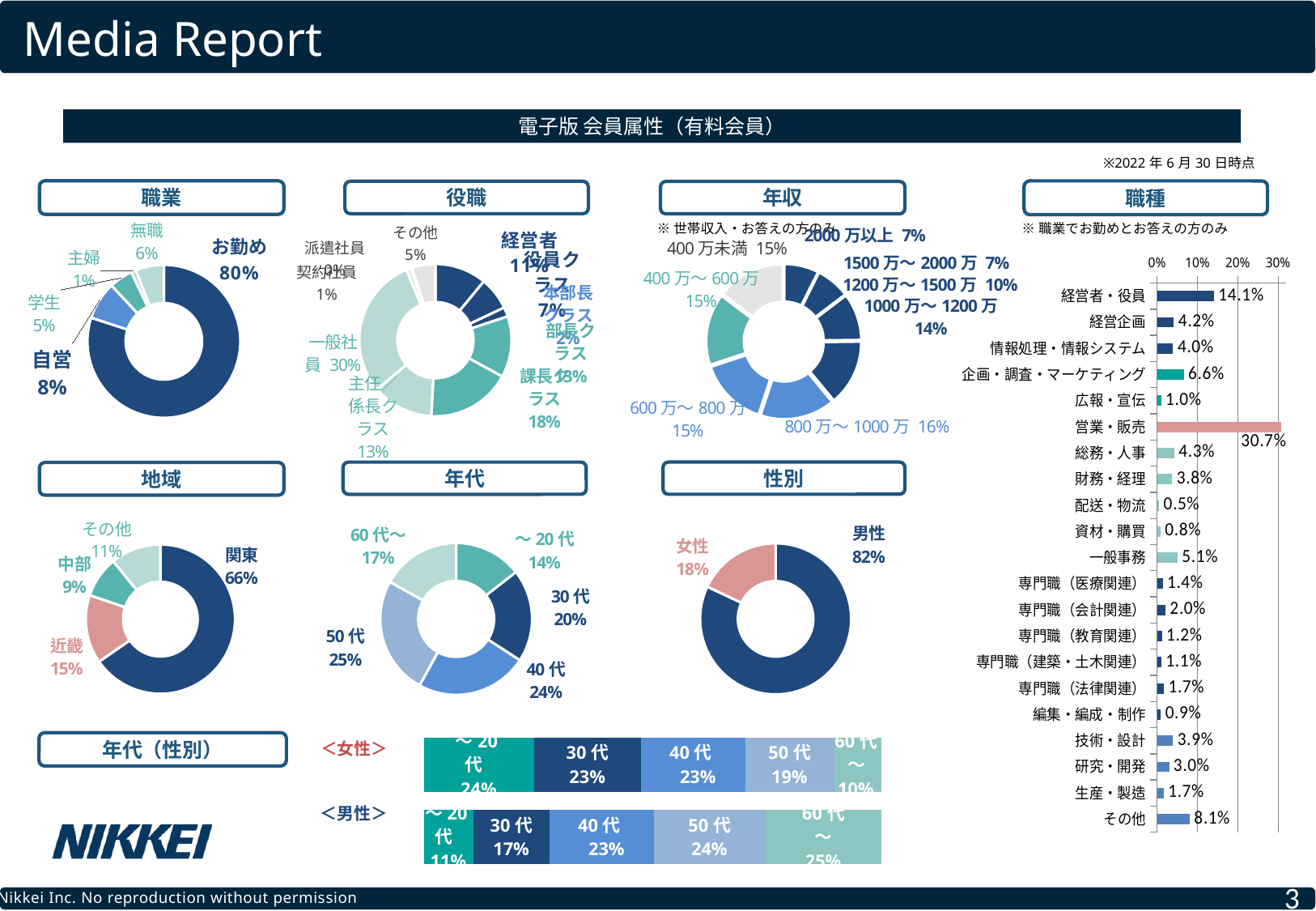
In the 地域 (region) donut chart, what is the difference between 関東 and 近畿? 51% In the 職種 (job type) bar chart, how many categories are shown? 21 What kind of chart is the 職種 (job type) chart? Bar chart In the 職種 (job type) bar chart, which category has the lowest value? 配送・物流 In the 職種 (job type) bar chart, which category has the highest value? 営業・販売 In the 年代（性別） stacked bar chart, what is the 60代～ share for 男性? 25% In the 年代 (age) donut chart, which is larger, 40代 or 30代? 40代 In the 年収 (income) donut chart, what percentage is 800万～1000万? 16% In the 職業 (occupation) donut chart, what percentage is 自営? 8% In the 性別 (gender) donut chart, what percentage is 男性? 82% In the 職種 (job type) bar chart, what is the value for 経営者・役員? 14.1% In the 地域 (region) donut chart, which region has the largest share? 関東